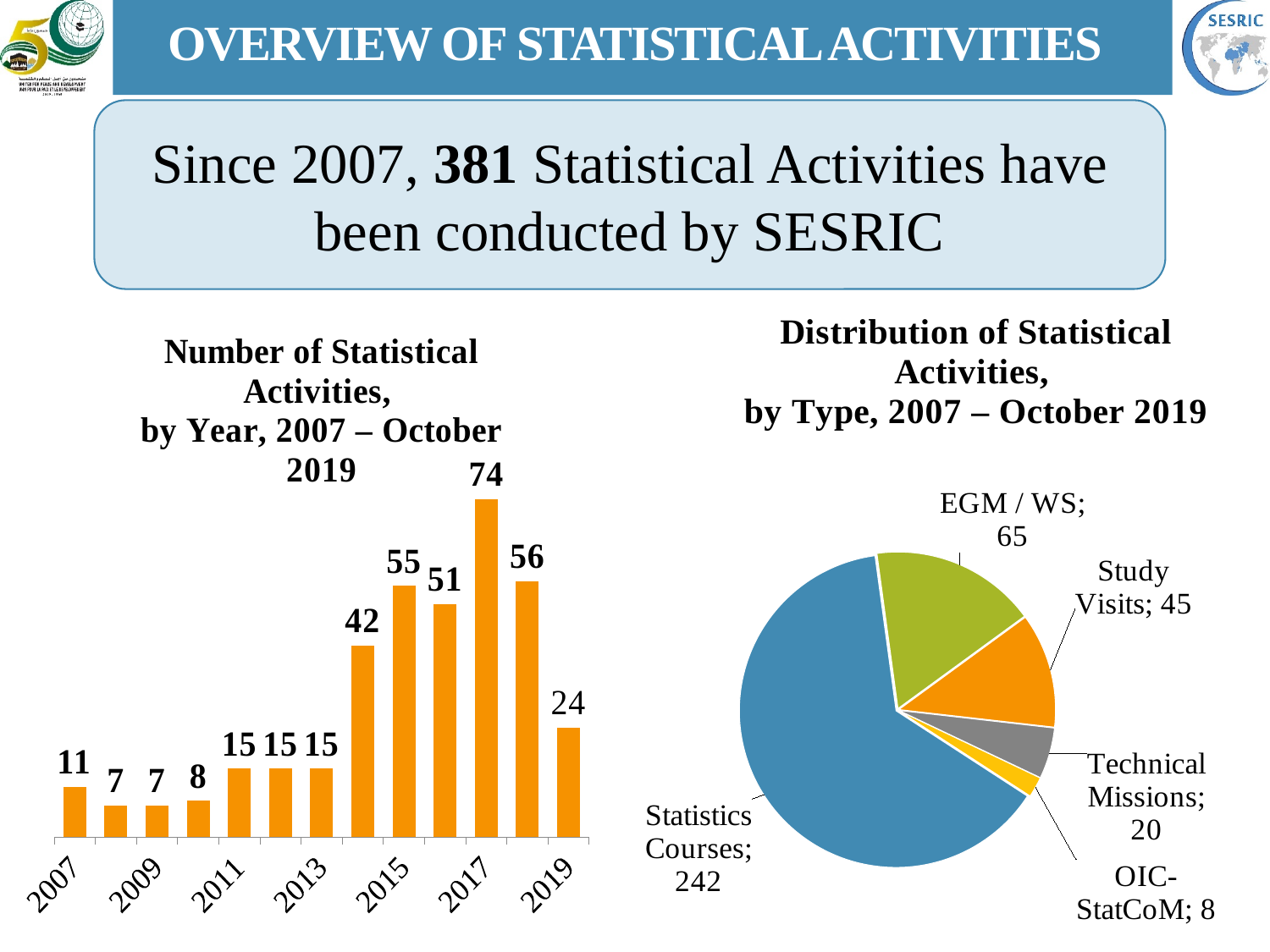
In the bar chart 'Number of Statistical Activities, by Year', what is the lowest value shown on any bar? 7 How many slices does the pie chart 'Distribution of Statistical Activities, by Type' have? 5 In the pie chart 'Distribution of Statistical Activities, by Type', how many activities are Study Visits? 45 What type of chart is the 'Number of Statistical Activities, by Year' chart on the left? Bar chart In the pie chart 'Distribution of Statistical Activities, by Type', what is the difference between the EGM / WS value and the Technical Missions value? 45 In the bar chart 'Number of Statistical Activities, by Year', what is the difference between the values for 2017 and 2019? 50 In the pie chart 'Distribution of Statistical Activities, by Type', which type has the smallest number of activities? OIC-StatCoM In the bar chart 'Number of Statistical Activities, by Year', how many statistical activities were conducted in 2017? 74 In the pie chart 'Distribution of Statistical Activities, by Type', which type has the largest number of activities? Statistics Courses In the bar chart 'Number of Statistical Activities, by Year', which year has the larger value, 2015 or 2019? 2015 In the bar chart 'Number of Statistical Activities, by Year', which year has the highest number of activities? 2017 How many bars are plotted in the bar chart 'Number of Statistical Activities, by Year'? 13